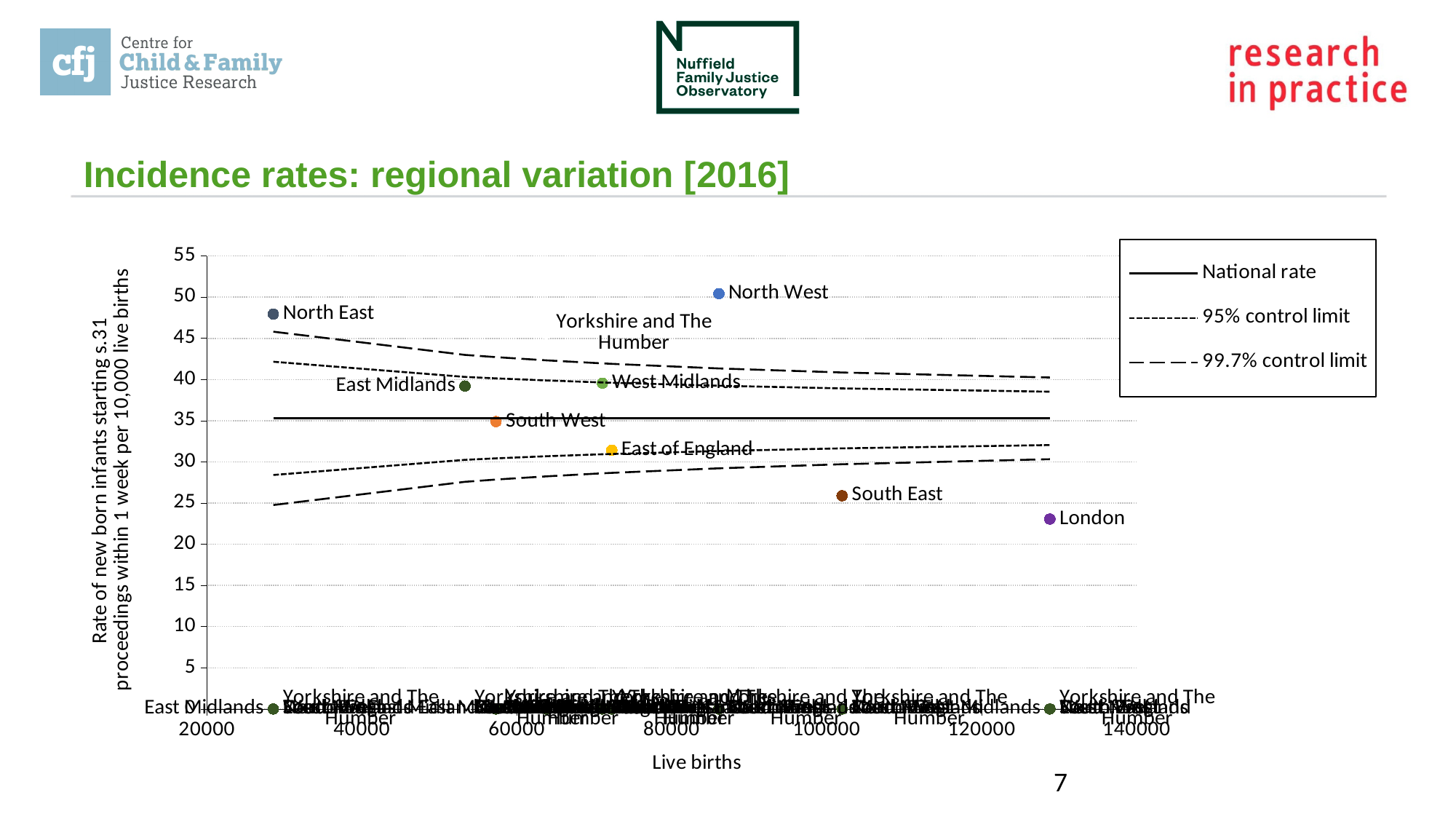
Is the rate for South West greater or less than 40? less Is the number of live births for London greater or less than 120000? greater What kind of chart is shown on the slide? scatter chart Is the rate for London greater or less than 25? less Which region has the higher rate, North East or London? North East How many entries does the chart legend list? 3 Which region has the highest rate of new born infants starting s.31 proceedings? North West Which region has the lowest rate of new born infants starting s.31 proceedings? London What is the label of the x axis? Live births Which region has the higher rate, South West or South East? South West